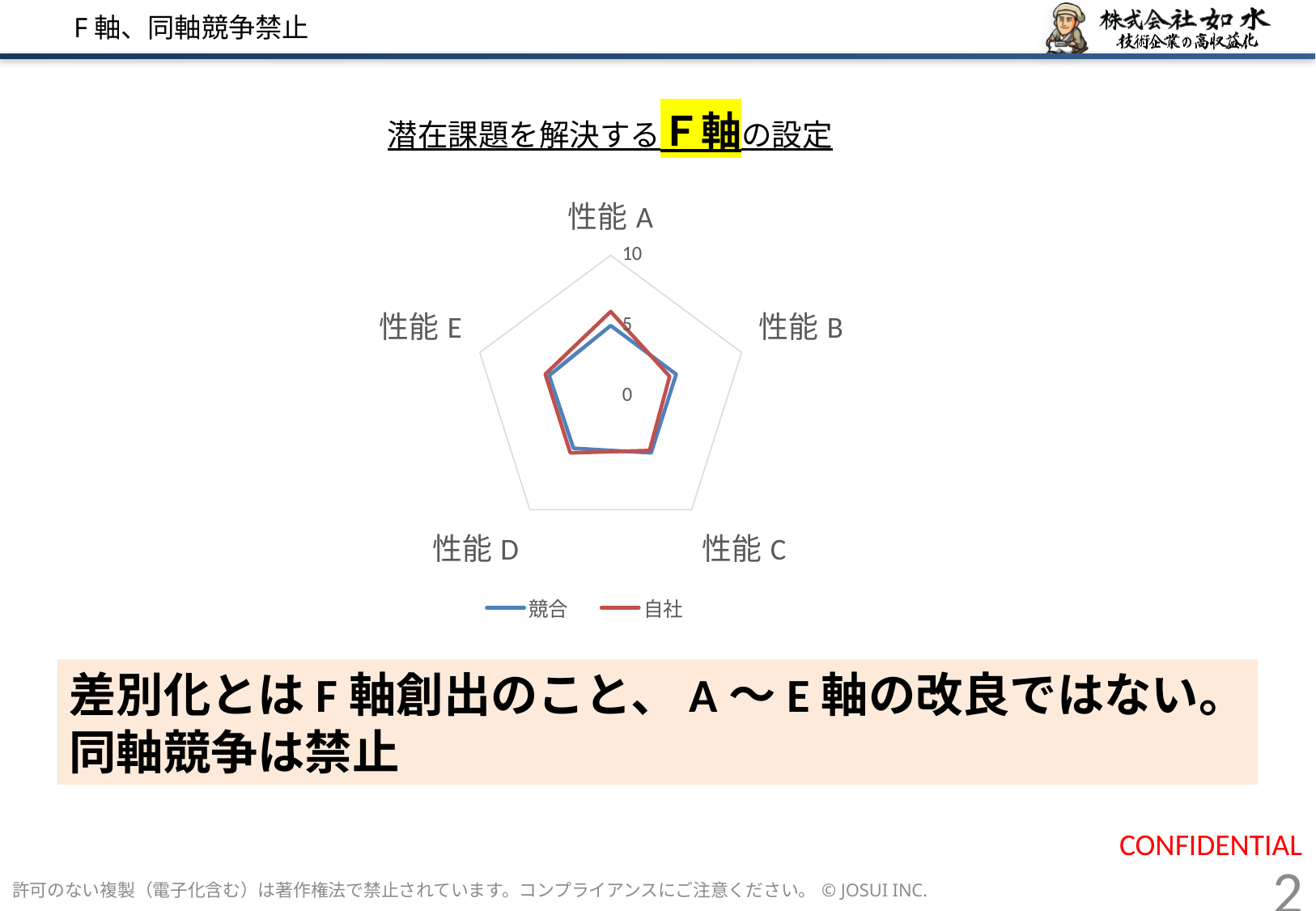
Is the value for 性能 A in the 自社 series greater or less than 10? less How many series does the legend of the radar chart list? 2 What are the two series named in the legend of the radar chart? 競合 and 自社 Which colour represents the 自社 series in the radar chart? red Is the value for 性能 B in the 競合 series greater or less than 10? less Is the value for 性能 C in the 自社 series greater or less than 10? less What kind of chart is shown on the slide? radar chart What is the maximum value shown on the radar chart's axis scale? 10 How many categories (axes) does the radar chart have? 5